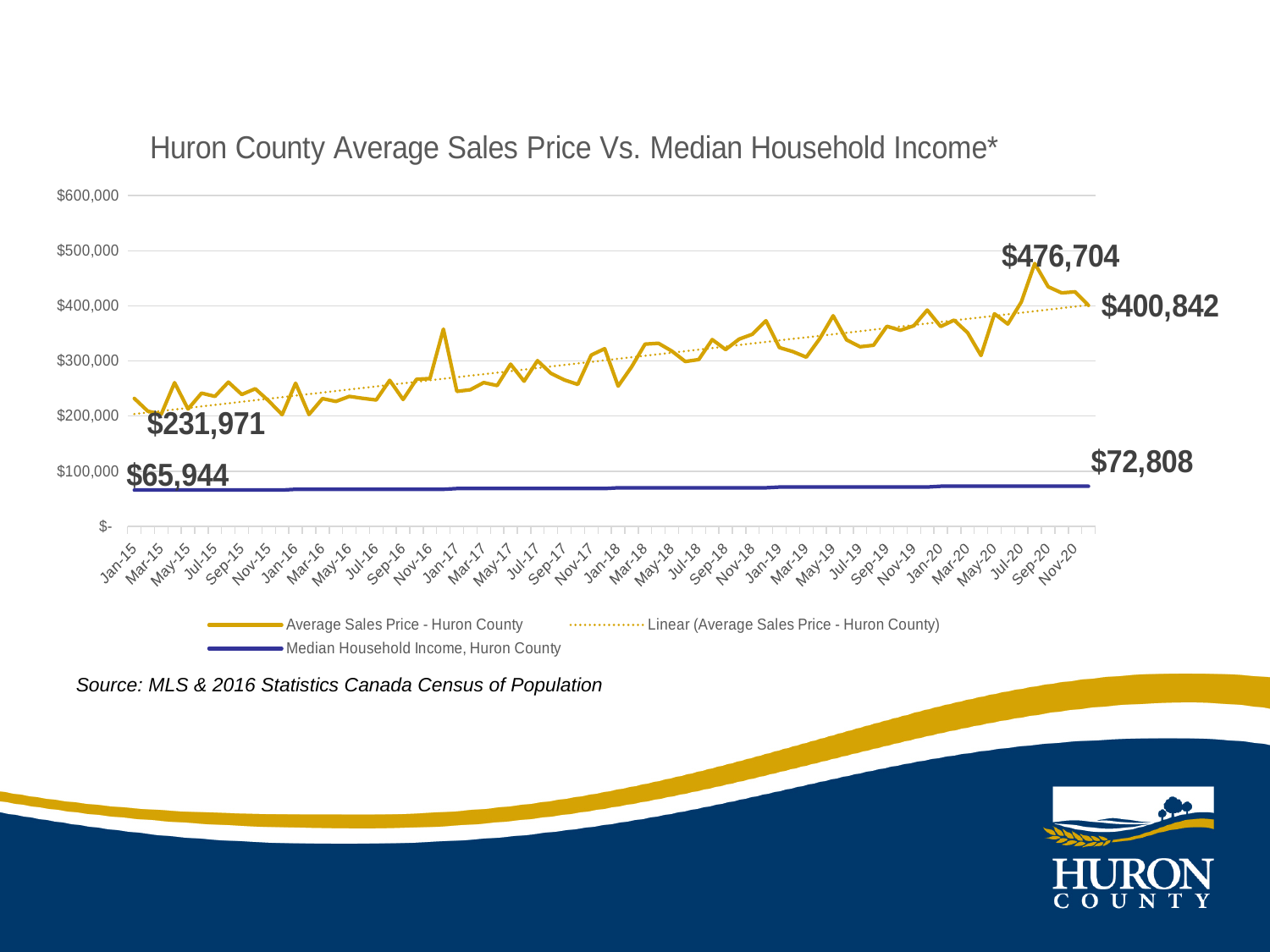
What is the labelled Median Household Income for Huron County at the start of the series? $65,944 By how much did the labelled Average Sales Price increase from $231,971 at the start to $400,842 at the end of the series? $168,871 How many entries does the chart legend list? 3 What is the title of the chart? Huron County Average Sales Price Vs. Median Household Income* Which series has higher values throughout the chart: Average Sales Price - Huron County or Median Household Income, Huron County? Average Sales Price - Huron County Does the Average Sales Price - Huron County series generally rise or fall from Jan-15 to Nov-20? Rise What is the labelled Average Sales Price for Huron County at the start of the series (Jan-15)? $231,971 What is the difference between the peak Average Sales Price of $476,704 and the final value of $400,842? $75,862 What is the labelled Average Sales Price for Huron County at the end of the series (late 2020)? $400,842 What is the labelled Median Household Income for Huron County at the end of the series? $72,808 What is the highest labelled value of the Average Sales Price - Huron County series? $476,704 What kind of chart is shown on the slide? Line chart